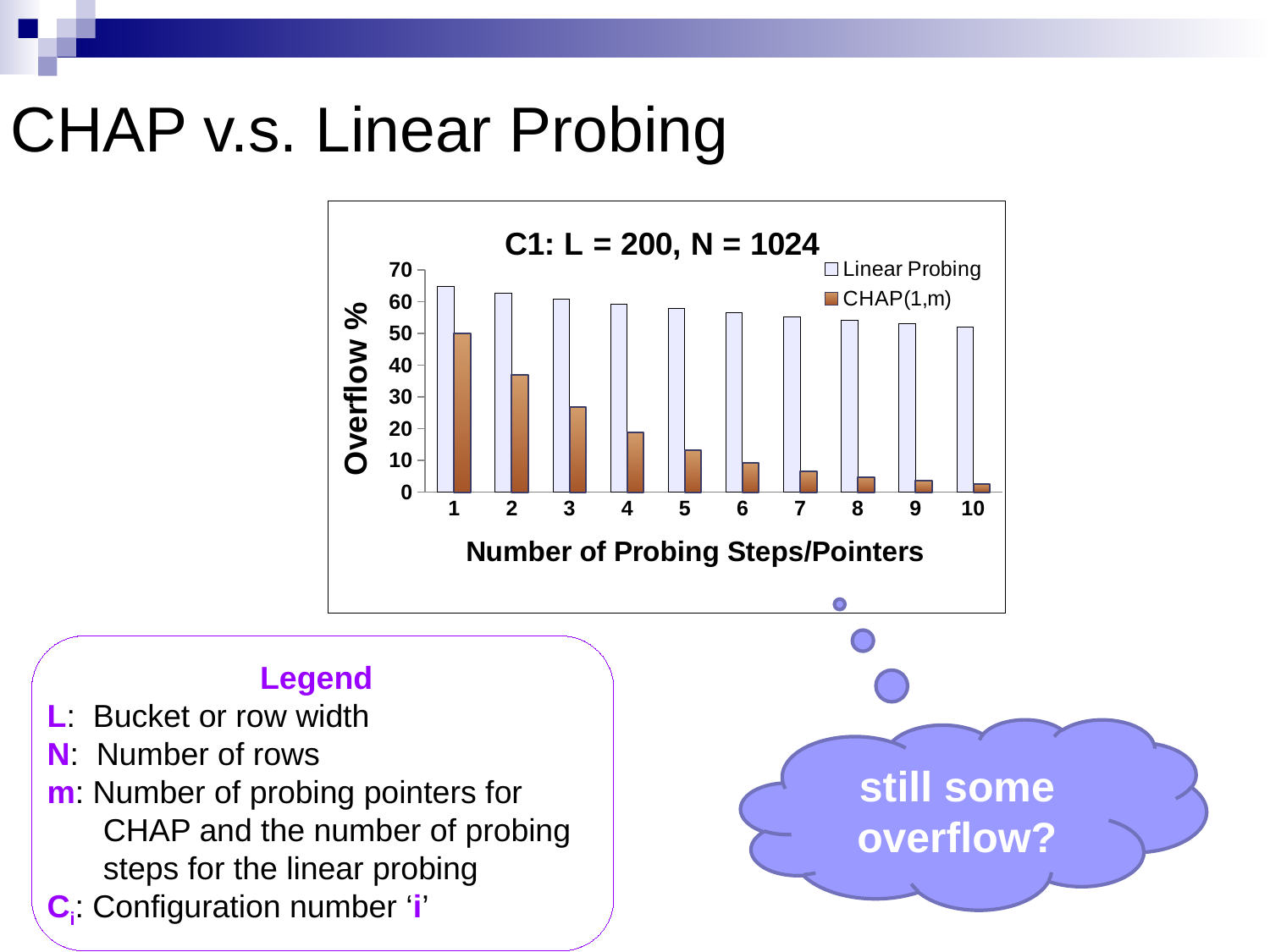
How many series does the chart's legend list? 2 At which number of probing steps is the Linear Probing overflow highest? 1 Is the CHAP(1,m) overflow at 2 probing pointers greater or less than 40? less Is the CHAP(1,m) overflow at 5 probing pointers greater or less than 10? greater What is the label of the chart's y axis? Overflow % How many probing step/pointer categories are shown on the x axis? 10 Does the CHAP(1,m) overflow rise or fall as the number of probing pointers increases from 1 to 10? fall What is the title of the chart? C1: L = 200, N = 1024 What kind of chart is shown on the slide? bar chart At 1 probing step/pointer, which series has the larger overflow, Linear Probing or CHAP(1,m)? Linear Probing Is the Linear Probing overflow at 10 probing steps greater or less than 50? greater At which number of probing pointers is the CHAP(1,m) overflow lowest? 10